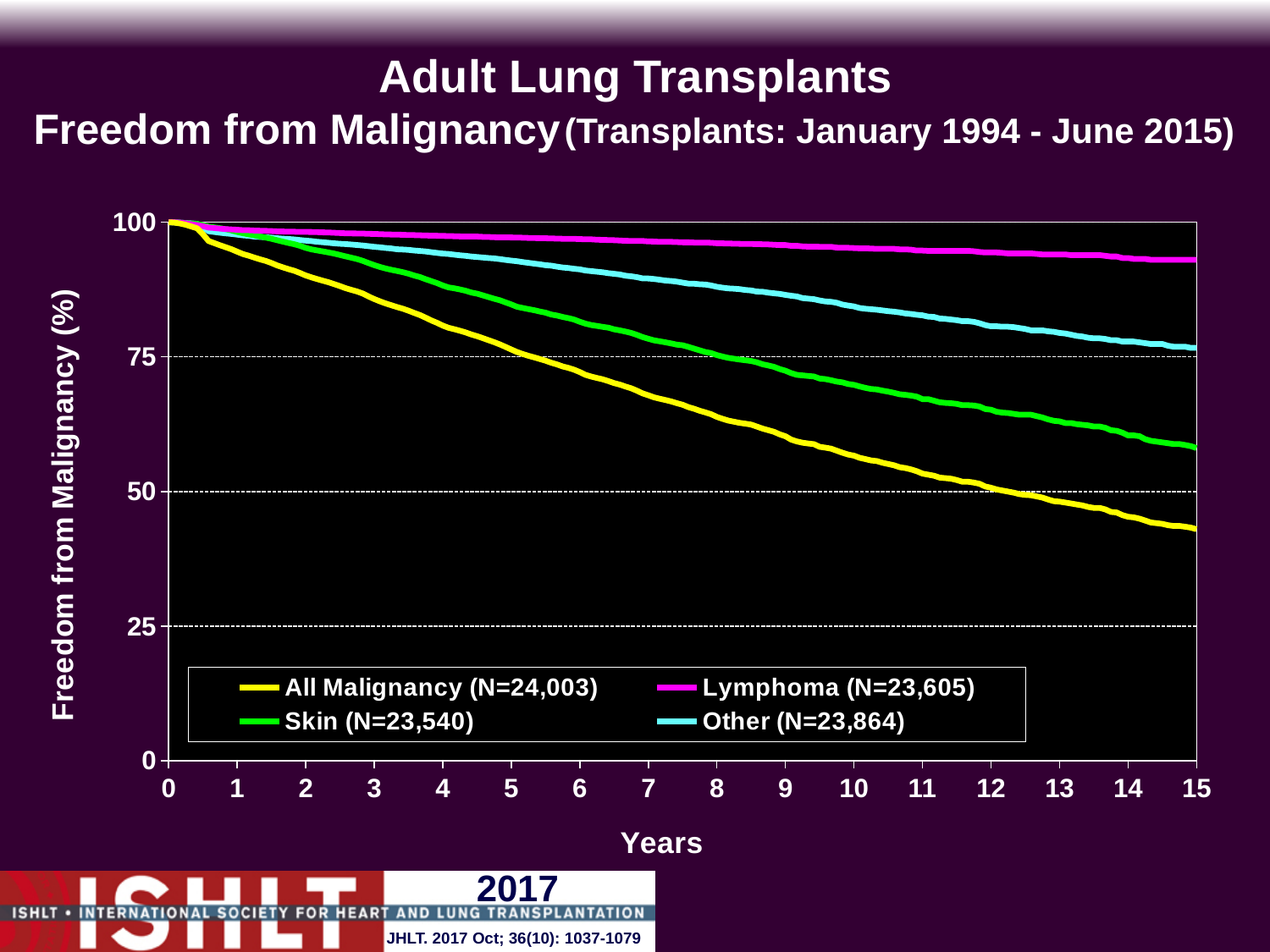
Is the value for Skin at 15 years greater or less than 50? greater At 10 years, which is larger: the value for Skin or the value for Other? Other What is the N for the Other series in the legend? N=23,864 What kind of chart is shown on the slide? line chart Which series has the lowest freedom from malignancy at 15 years? All Malignancy (N=24,003) Do the values for Skin rise or fall as years increase? fall Which series has the highest freedom from malignancy at 15 years? Lymphoma (N=23,605) Is the value for All Malignancy at 15 years greater or less than 50? less How many series does the legend list? 4 What colour is the Lymphoma line? magenta Is the value for All Malignancy at 10 years greater or less than 50? greater